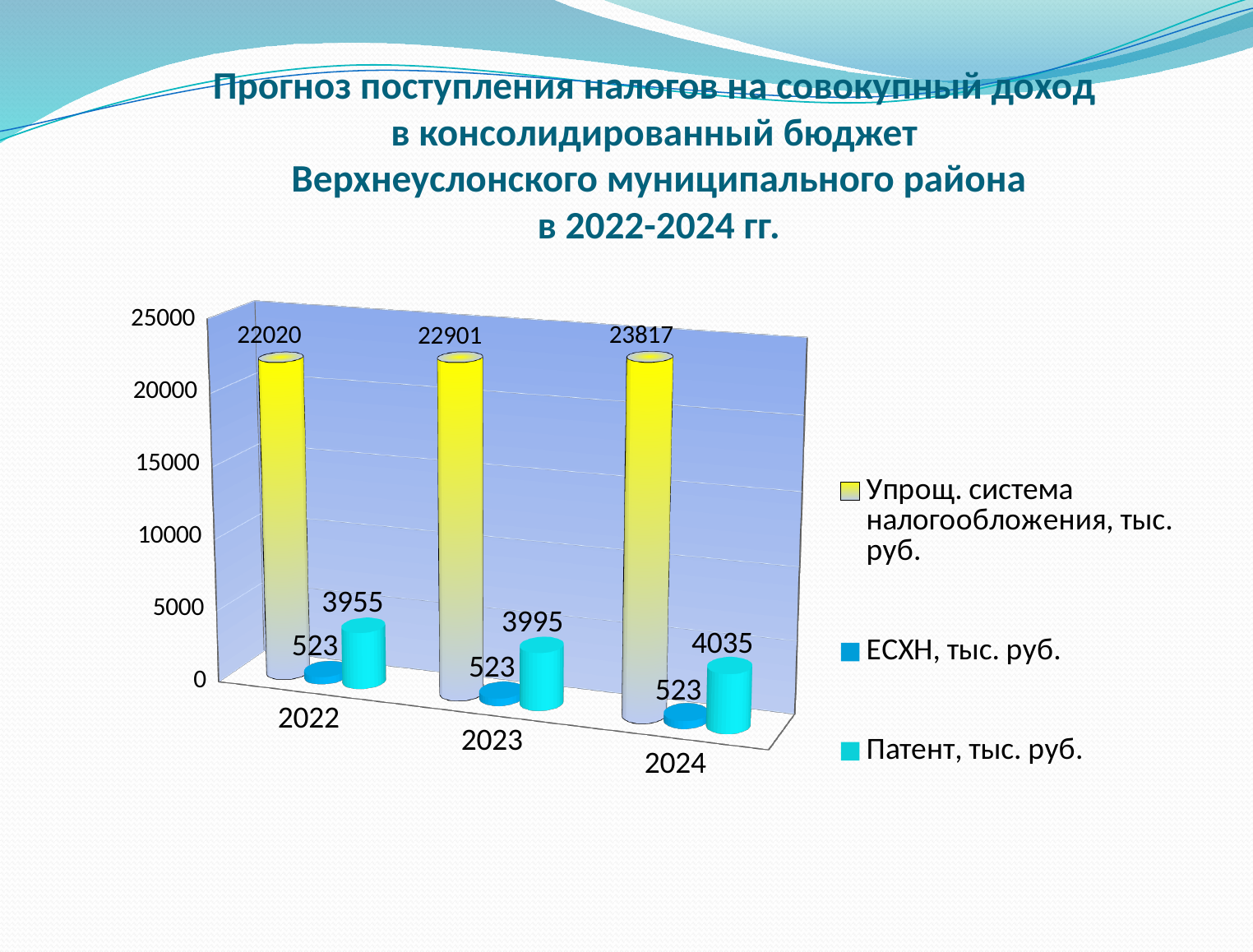
Which is larger in 2022: the Патент value or the ЕСХН value? Патент In which year is the Упрощ. система налогообложения value highest? 2024 How many years are shown on the x axis? 3 What is the value for Патент in 2024? 4035 How many series does the legend list? 3 In which year is the Патент value lowest? 2022 What is the difference between the Патент values for 2023 and 2022? 40 What is the value for ЕСХН in 2023? 523 What is the value for Упрощ. система налогообложения in 2022? 22020 What is the difference between the Упрощ. система налогообложения values for 2024 and 2023? 916 What kind of chart is shown on the slide? Bar chart Do the Упрощ. система налогообложения values rise or fall from 2022 to 2024? Rise